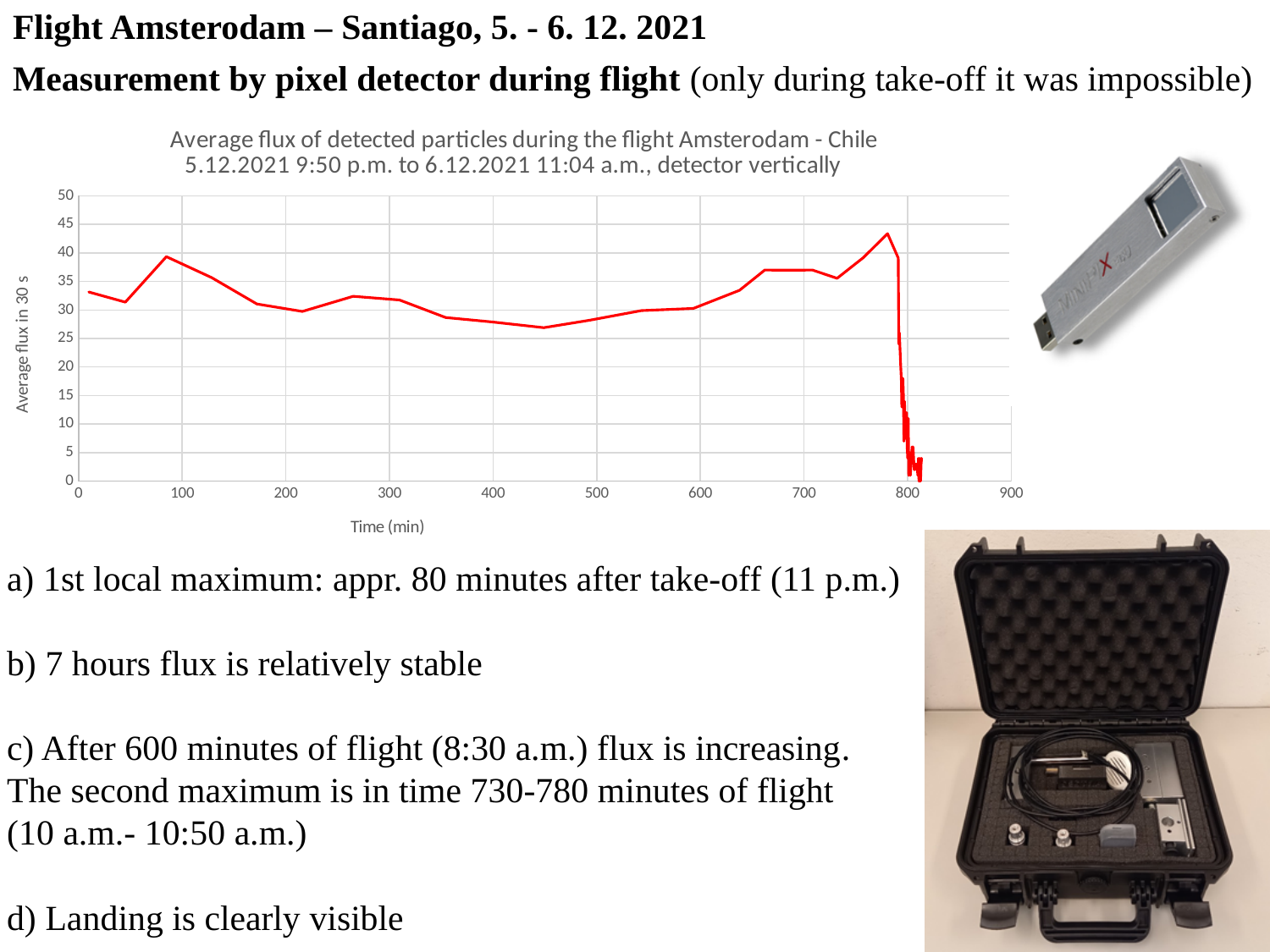
Is the value of the average flux at 100 minutes greater or less than 35? greater Is the peak value of the average flux near 780 minutes greater or less than 40? greater Is the average flux at 700 minutes larger or smaller than at 400 minutes? larger Is the value of the average flux at 300 minutes greater or less than 35? less Is the average flux at 780 minutes larger or smaller than at 450 minutes? larger What kind of chart is shown on the slide? line chart Does the average flux rise or fall between 100 and 200 minutes? fall What is the title of the chart? Average flux of detected particles during the flight Amsterodam - Chile 5.12.2021 9:50 p.m. to 6.12.2021 11:04 a.m., detector vertically Does the average flux rise or fall between 600 and 780 minutes? rise What is the label of the vertical axis of the chart? Average flux in 30 s